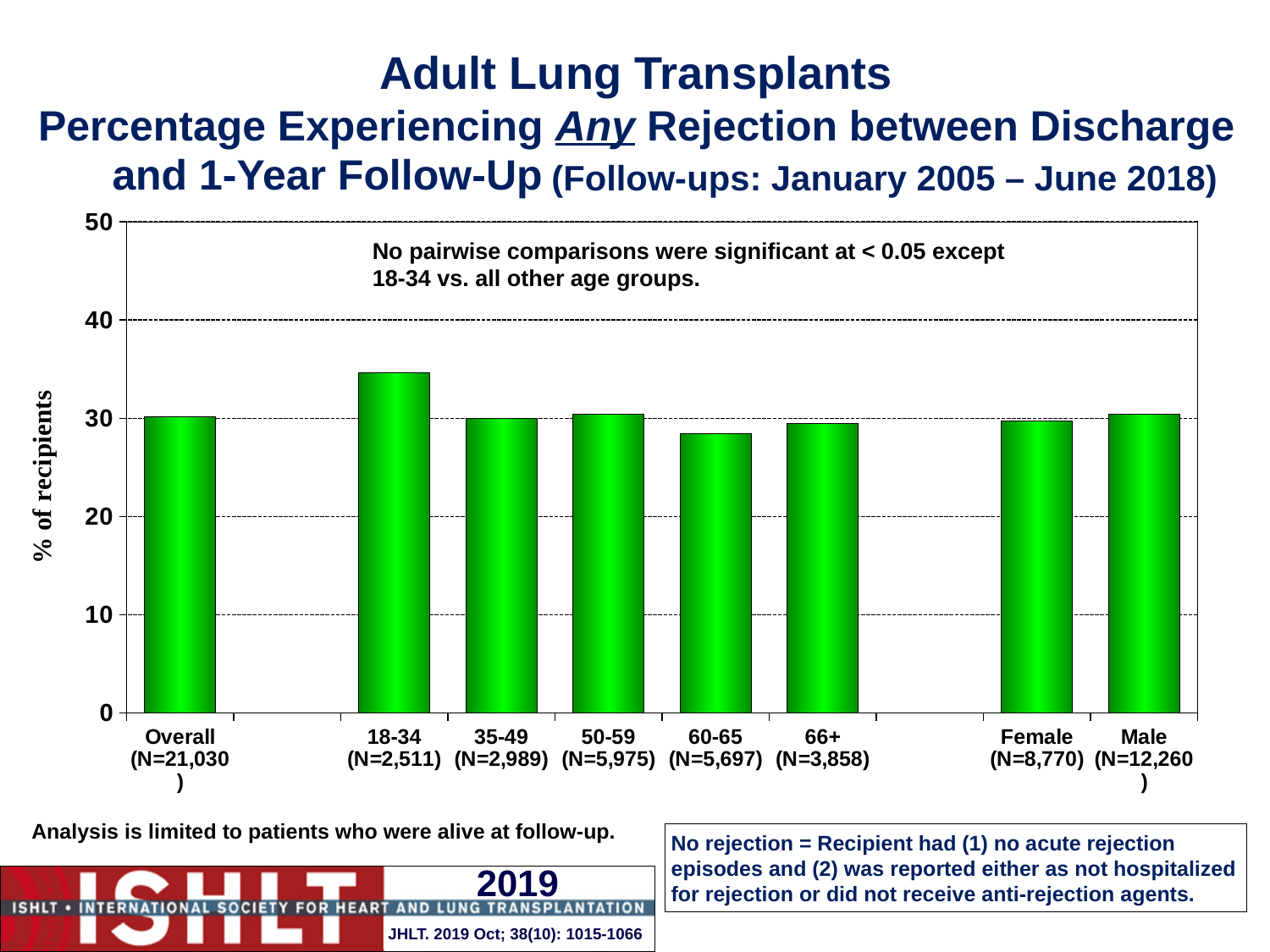
What kind of chart is shown on the slide? bar chart Is the value for the 60-65 age group greater or less than 30? less Is the value for the 18-34 age group greater or less than 30? greater Is the value for the 18-34 age group greater or less than 40? less What is the N shown for the Overall category? N=21,030 Which is larger, the value for 18-34 or the value for 60-65? 18-34 Which is larger, the value for 18-34 or the value for 35-49? 18-34 Which category has the highest percentage of recipients experiencing any rejection? 18-34 Which is larger, the value for 18-34 or the value for Male? 18-34 How many bars are plotted in the chart? 8 What is the label of the y-axis? % of recipients